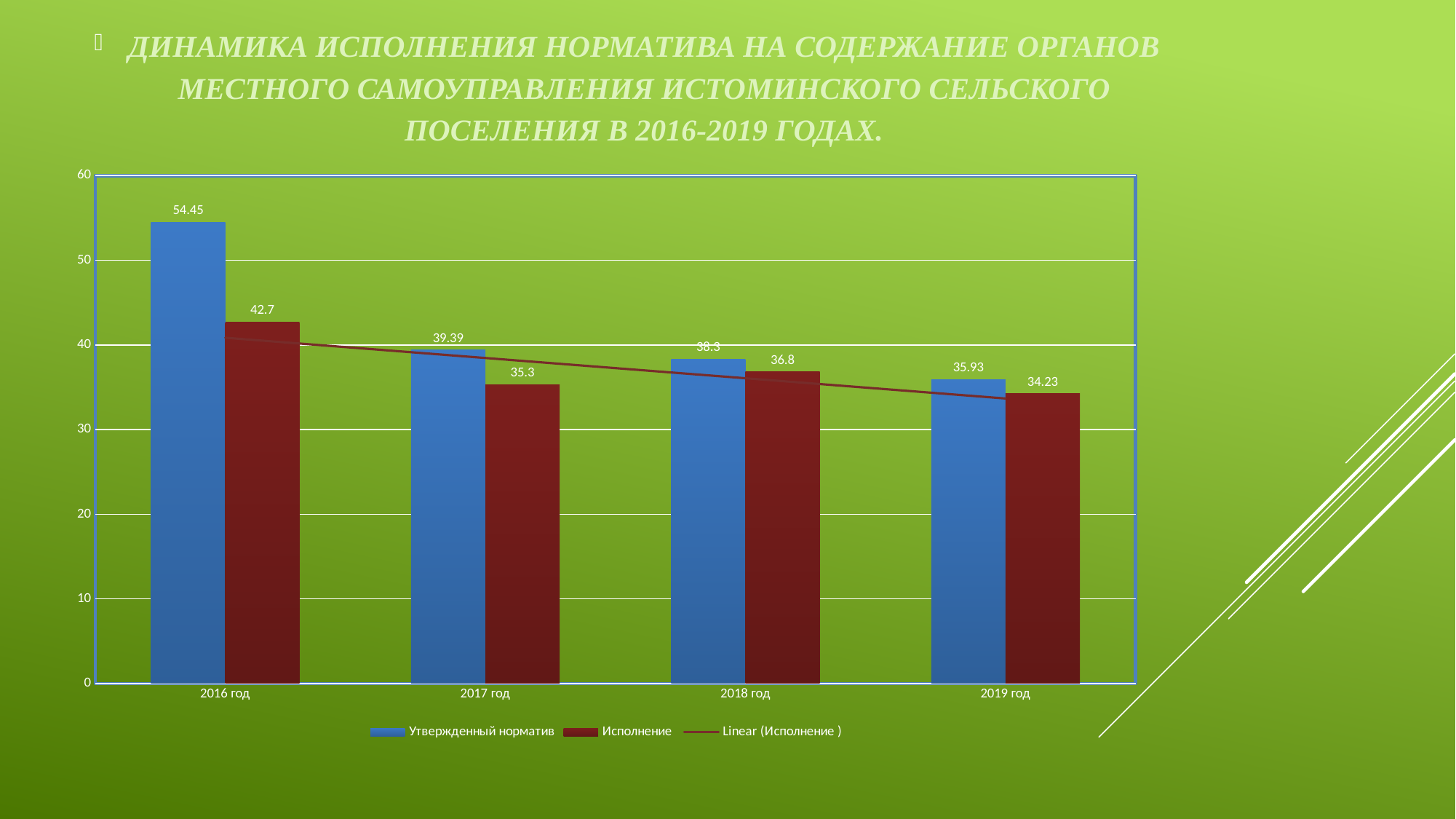
Is the value of Утвержденный норматив for 2017 год greater or less than 40? less In which year is Исполнение the lowest? 2019 год How many entries does the legend list? 3 How many years are shown on the x axis? 4 Which is larger in 2018 год: Утвержденный норматив or Исполнение? Утвержденный норматив Does the Исполнение series rise or fall from 2016 год to 2019 год? fall What is the value of Утвержденный норматив for 2016 год? 54.45 In which year is Утвержденный норматив the highest? 2016 год What is the difference between Утвержденный норматив and Исполнение in 2016 год? 11.75 What is the value of Исполнение for 2017 год? 35.3 What kind of chart is shown on the slide? bar chart What is the value of Исполнение for 2019 год? 34.23